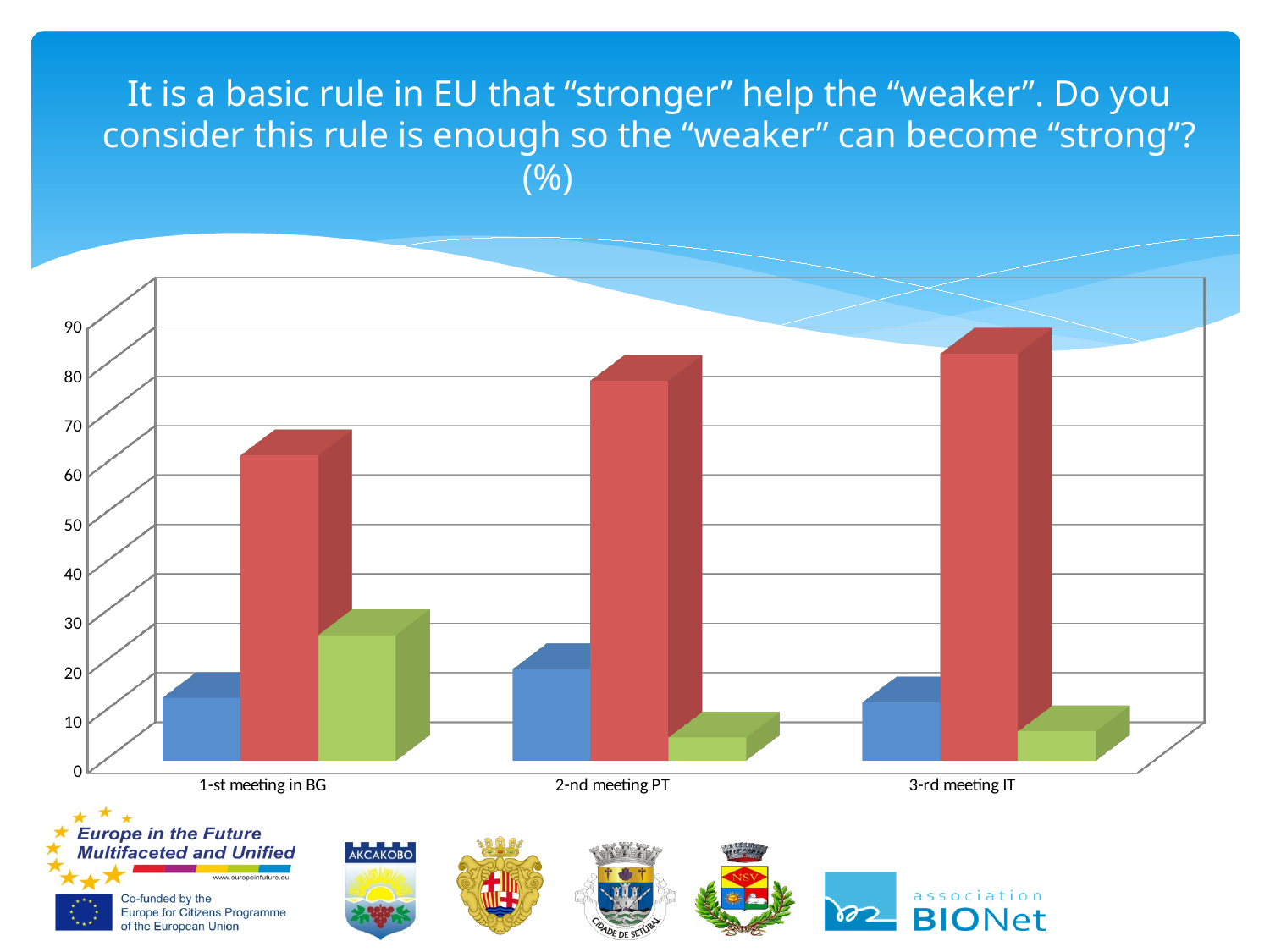
Is the value of the blue bar for 2-nd meeting PT greater or less than 30? less Is the value of the green bar for 2-nd meeting PT greater or less than 10? less Is the value of the red bar for 1-st meeting in BG greater or less than 50? greater Which is larger: the green bar for 1-st meeting in BG or the green bar for 2-nd meeting PT? 1-st meeting in BG How many meeting categories are shown on the x axis? 3 How many bars are shown for each meeting category? 3 Which is larger: the red bar for 2-nd meeting PT or the red bar for 1-st meeting in BG? 2-nd meeting PT Do the red bars rise or fall from the 1-st meeting in BG to the 3-rd meeting IT? rise Which meeting has the tallest red bar? 3-rd meeting IT What kind of chart is shown on the slide? bar chart